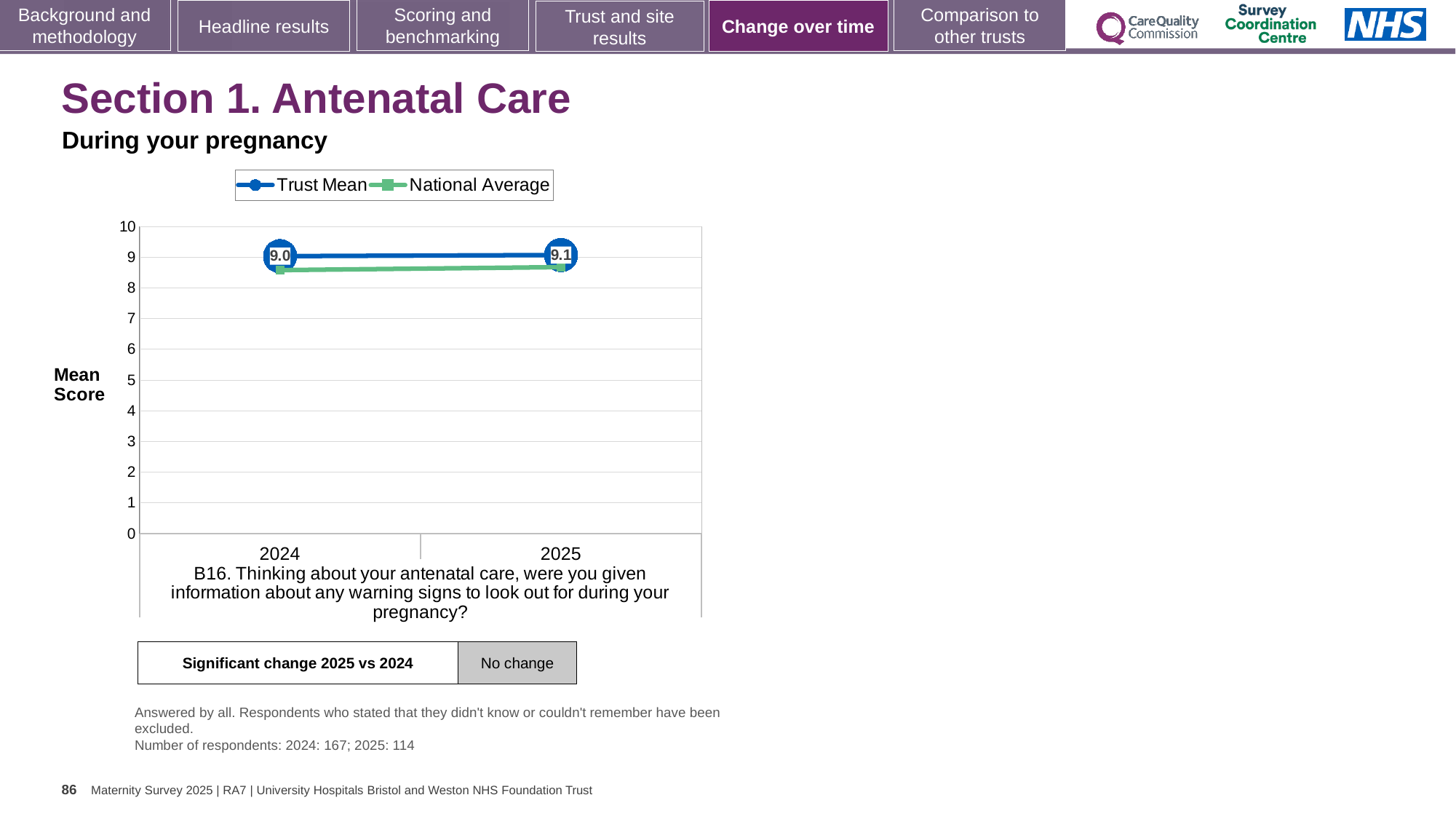
Is the National Average for 2024 greater or less than 9? less Is the National Average for 2025 greater or less than 8? greater How many years are plotted on the x axis? 2 Does the Trust Mean rise or fall from 2024 to 2025? Rise How many series does the legend list? 2 What is the difference between the Trust Mean scores for 2025 and 2024? 0.1 What is the Trust Mean score for 2025? 9.1 What kind of chart is shown on the slide? Line chart Which year has the lower Trust Mean score? 2024 In 2024, which is higher: the Trust Mean or the National Average? Trust Mean What is the Trust Mean score for 2024? 9.0 Which year has the higher Trust Mean score? 2025